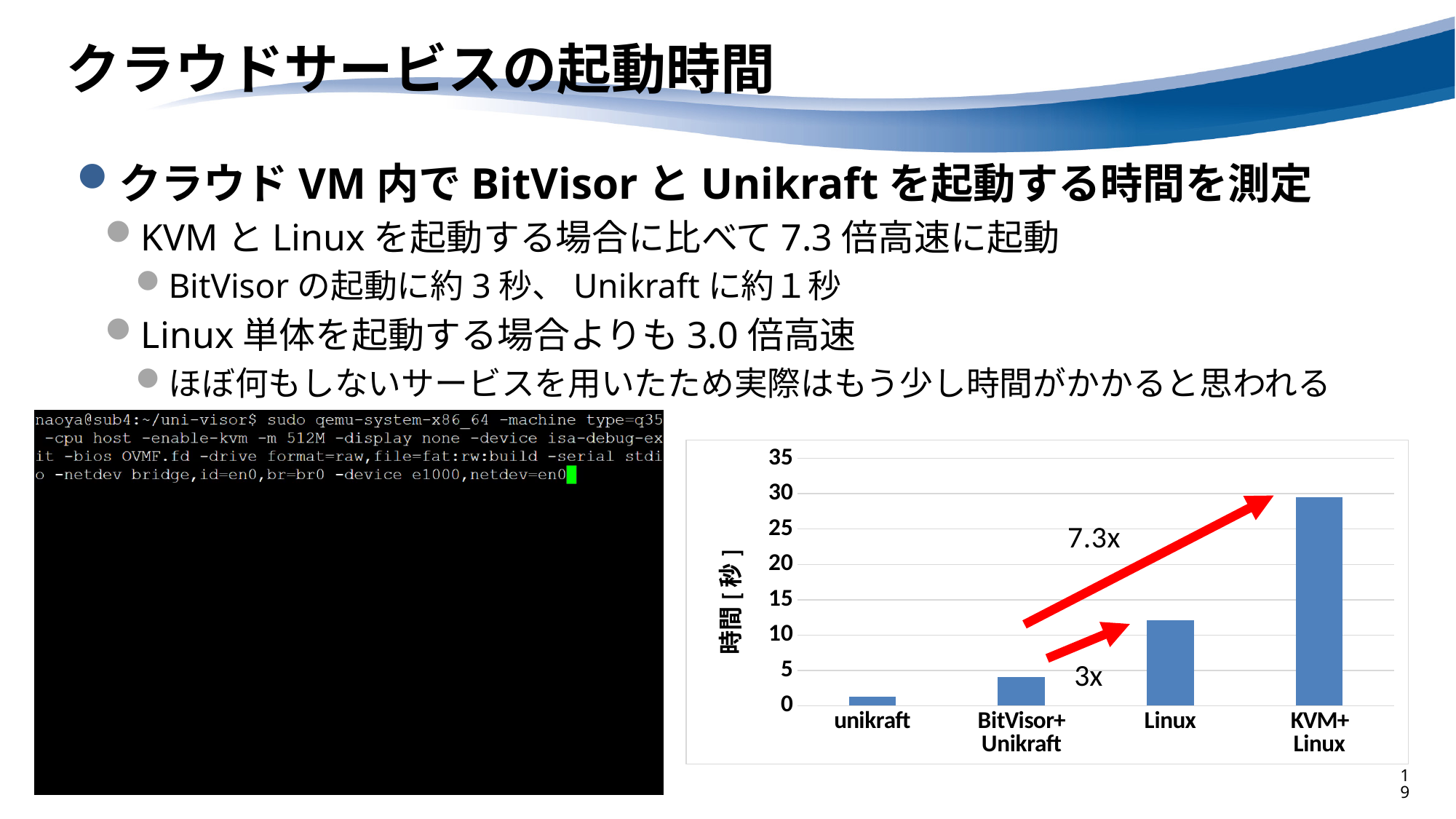
Which has a larger value, Linux or BitVisor+Unikraft? Linux What speedup factor is annotated on the arrow from BitVisor+Unikraft to KVM+Linux? 7.3x Which has a larger value, KVM+Linux or Linux? KVM+Linux What kind of chart is shown on the slide? bar chart Is the value for BitVisor+Unikraft greater or less than 5? less Which category has the lowest bar in the chart? unikraft Is the value for Linux greater or less than 10? greater Is the value for KVM+Linux greater or less than 25? greater Do the bar values rise or fall from left to right along the x axis? rise What is the label of the y axis of the chart? 時間 [秒] Which category has the highest bar in the chart? KVM+Linux How many categories are shown on the x axis of the chart? 4